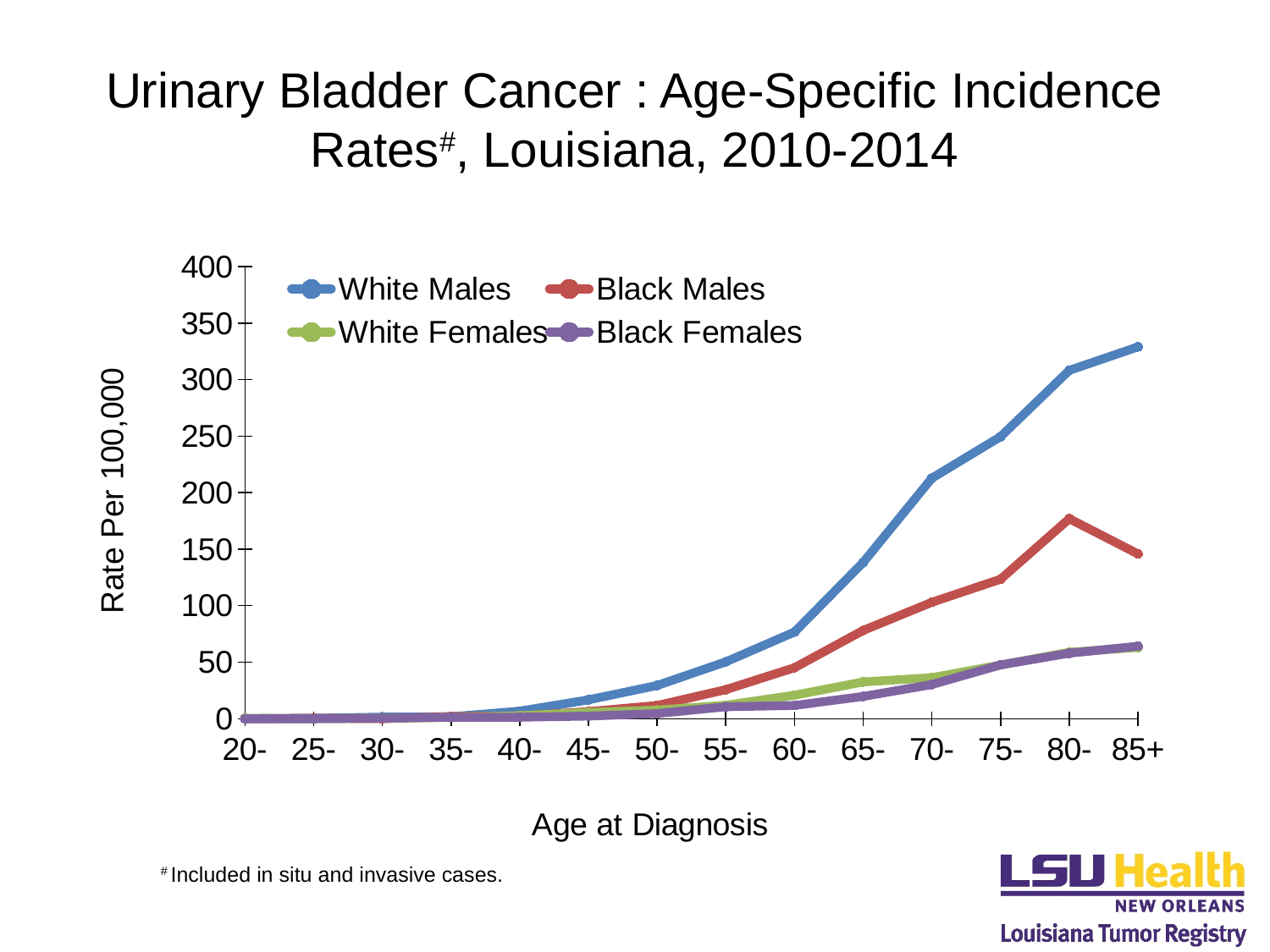
What kind of chart is shown on the slide? line chart Does the Black Males rate rise or fall from age 80- to 85+? fall What is the label on the y axis? Rate Per 100,000 How many series does the legend list? 4 How many age groups are shown along the x axis? 14 Is the value for White Males at age 70- greater or less than 200? greater At age 80-, which is larger: the rate for White Males or for Black Males? White Males Is the value for White Males at age 85+ greater or less than 300? greater Do the White Males rates rise or fall as age at diagnosis increases? rise Which series has the highest rate at age 85+? White Males Is the value for Black Males at age 80- greater or less than 150? greater